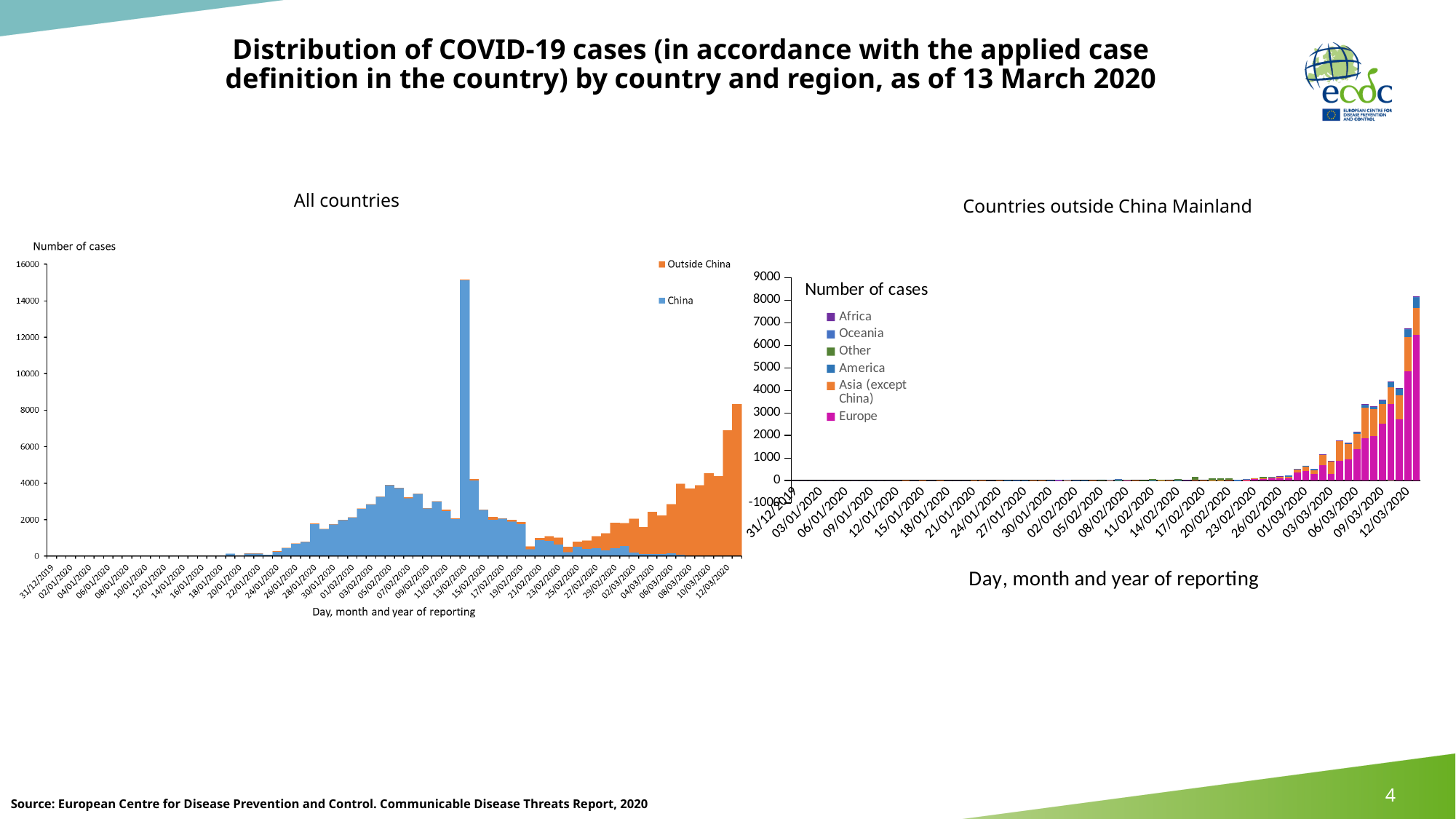
In the 'All countries' chart, which series accounts for most of the cases on 12/03/2020, China or Outside China? Outside China In the 'Countries outside China Mainland' chart, which region is shown in magenta/pink? Europe What kind of chart is the 'All countries' chart on the left? bar chart In the 'Countries outside China Mainland' chart, do the number of cases generally rise or fall from late February to 12/03/2020? rise What is the x-axis label of the 'Countries outside China Mainland' chart? Day, month and year of reporting In the 'All countries' chart, which series accounts for most of the cases on 13/02/2020, China or Outside China? China In the 'All countries' chart, on which reporting date is the total number of cases highest? 13/02/2020 How many series does the legend of the 'Countries outside China Mainland' chart list? 6 How many series does the legend of the 'All countries' chart list? 2 In the 'All countries' chart, is the total number of cases on 13/02/2020 greater or less than 14000? greater